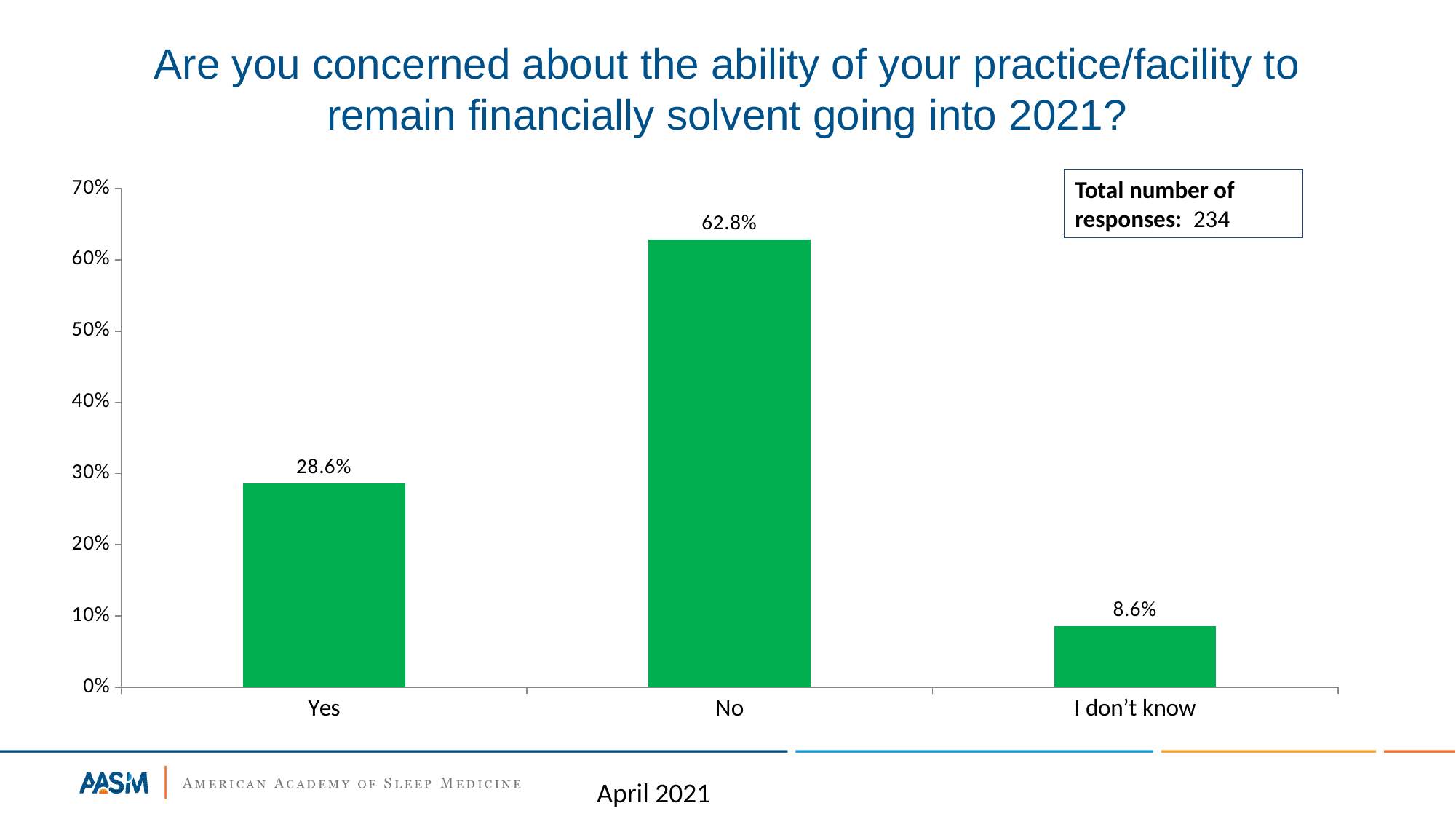
What is the difference in percentage points between the "Yes" and "I don't know" responses? 20 Is the value for "No" greater or less than 60%? greater What percentage of respondents answered "No"? 62.8% What is the difference in percentage points between the "No" and "Yes" responses? 34.2 What kind of chart is shown on the slide? Bar chart Which response category has the lowest percentage? I don't know Which response category has the highest percentage? No What is the total number of responses stated on the slide? 234 What percentage of respondents answered "I don't know"? 8.6% How many response categories are shown on the chart? 3 What percentage of respondents answered "Yes"? 28.6% Which is larger, the percentage for "Yes" or for "I don't know"? Yes